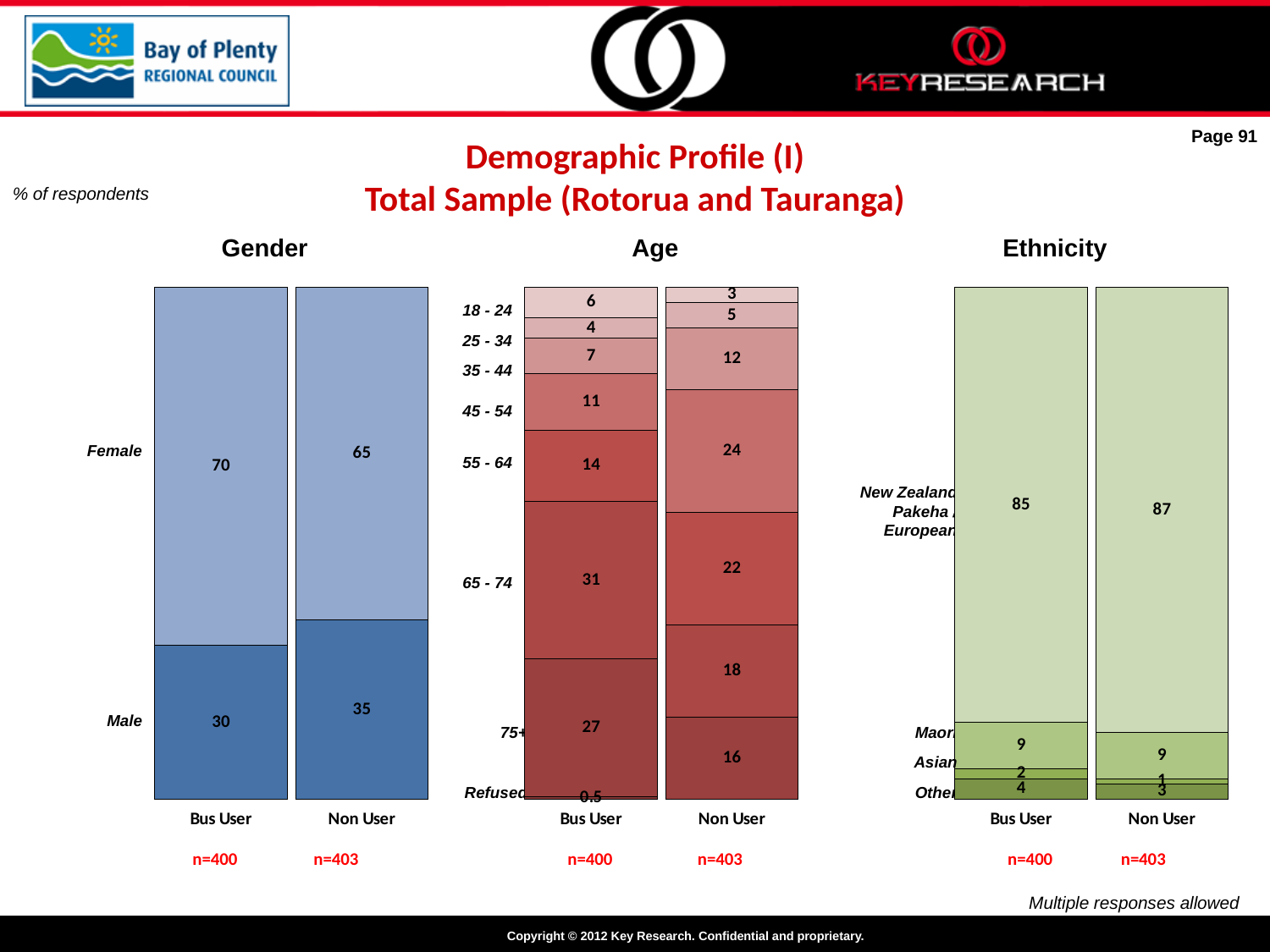
In the Ethnicity chart, what is the New Zealand Pakeha / European value for Non Users? 87 In the Age chart, which age group has the smallest share among Non Users? 18 - 24 In the Gender chart, what is the difference between the Female values for Bus Users and Non Users? 5 In the Age chart, which is larger: the 45 - 54 value for Bus Users or for Non Users? Non Users In the Age chart, what is the value for the 65 - 74 group among Bus Users? 31 What kind of chart is the Gender chart? Stacked bar chart In the Ethnicity chart, what is the difference between the Maori values for Bus Users and Non Users? 0 In the Age chart, what is the value for the 75+ group among Non Users? 16 In the Gender chart, what percentage of Bus Users are Female? 70 In the Ethnicity chart, what is the Asian value for Bus Users? 2 In the Gender chart, what is the Male value for Non Users? 35 In the Age chart, which age group has the largest share among Bus Users? 65 - 74